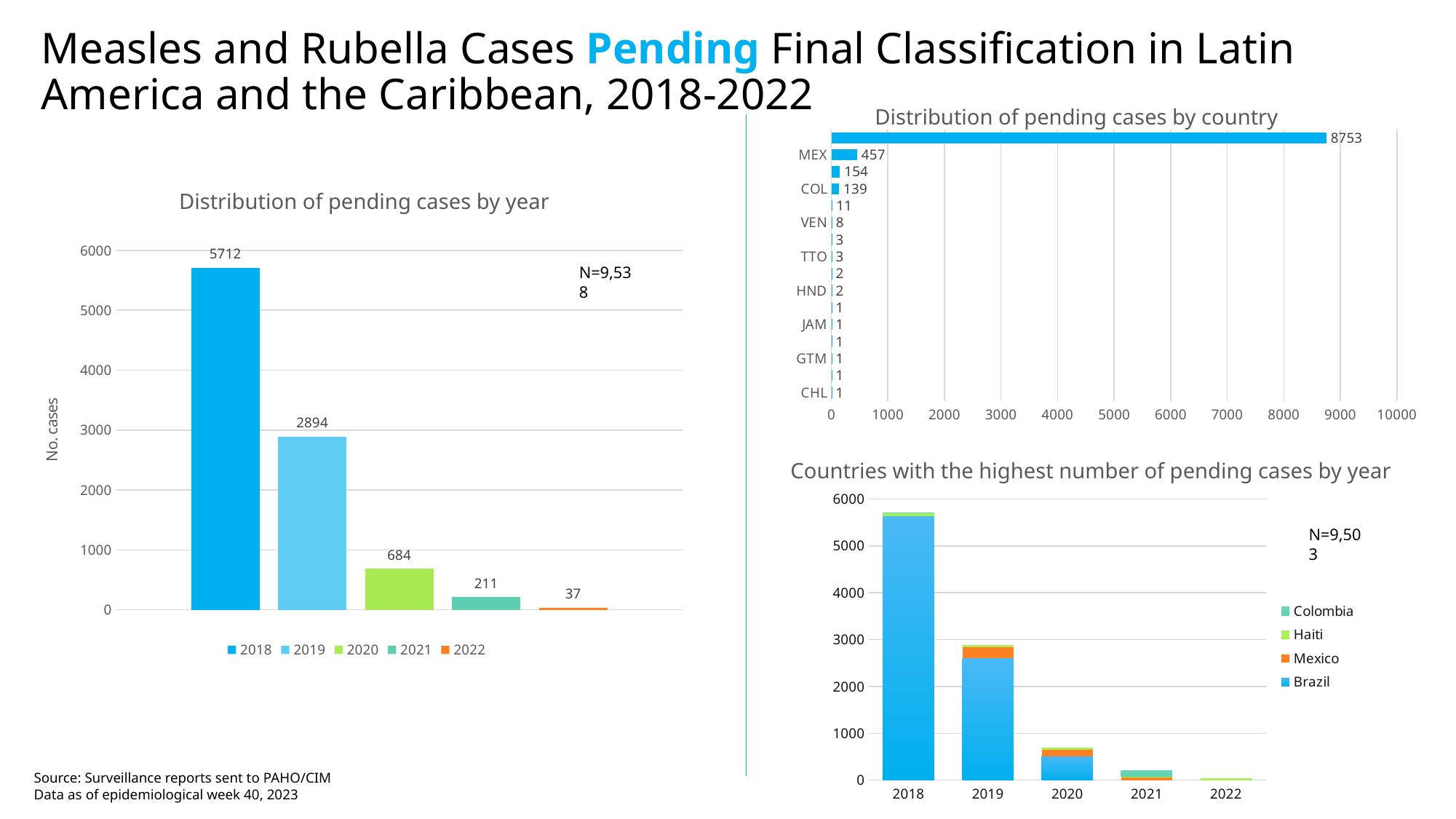
In the 'Distribution of pending cases by year' chart, which year has the lowest number of pending cases? 2022 In the 'Distribution of pending cases by year' chart, what is the difference between the 2018 and 2019 values? 2818 In the 'Distribution of pending cases by year' chart, which year has more pending cases, 2020 or 2021? 2020 In the 'Distribution of pending cases by year' chart, do the values rise or fall from 2018 to 2022? fall In the 'Countries with the highest number of pending cases by year' chart, is the total stacked value for 2018 greater or less than 5000? greater In the 'Distribution of pending cases by country' chart, how many pending cases are shown for MEX? 457 In the 'Distribution of pending cases by country' chart, how many pending cases are shown for COL? 139 What kind of chart is 'Distribution of pending cases by country'? bar chart How many series does the legend of the 'Countries with the highest number of pending cases by year' chart list? 4 In the 'Distribution of pending cases by year' chart, how many pending cases are shown for 2022? 37 In the 'Distribution of pending cases by year' chart, how many pending cases are shown for 2018? 5712 How many years (bars) are plotted in the 'Distribution of pending cases by year' chart? 5